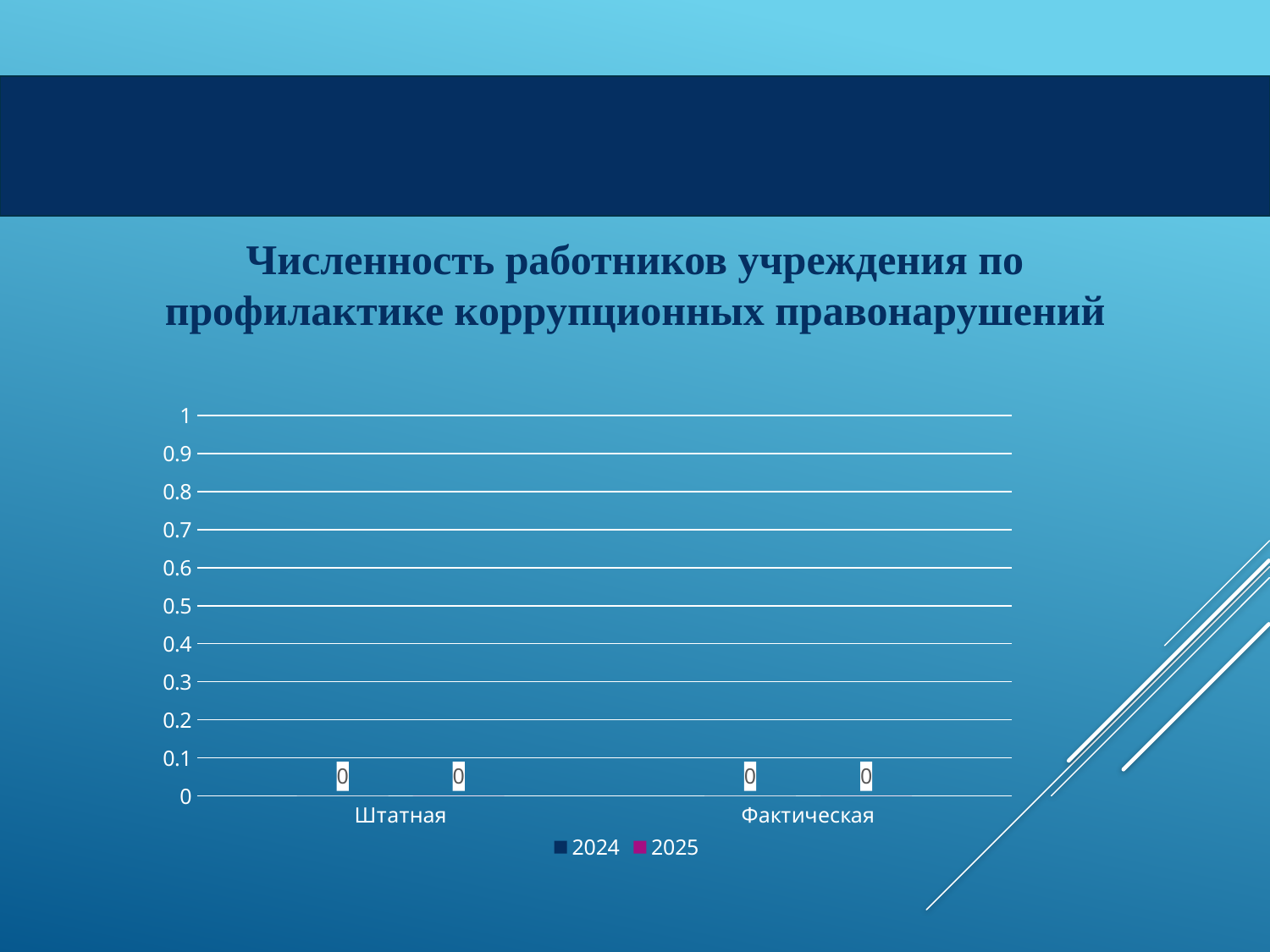
Which series are listed in the chart legend? 2024 and 2025 Is the value for Фактическая in 2025 greater or less than 0.5? less What is the value for Штатная in the 2024 series? 0 What is the value for Штатная in the 2025 series? 0 What is the value for Фактическая in the 2025 series? 0 What is the value for Фактическая in the 2024 series? 0 What is the difference between the 2024 and 2025 values for Штатная? 0 How many series does the legend list? 2 What is the highest value shown on the vertical axis of the chart? 1 What kind of chart is shown on the slide? bar chart What is the difference between the 2024 and 2025 values for Фактическая? 0 How many categories are shown on the x axis of the chart? 2